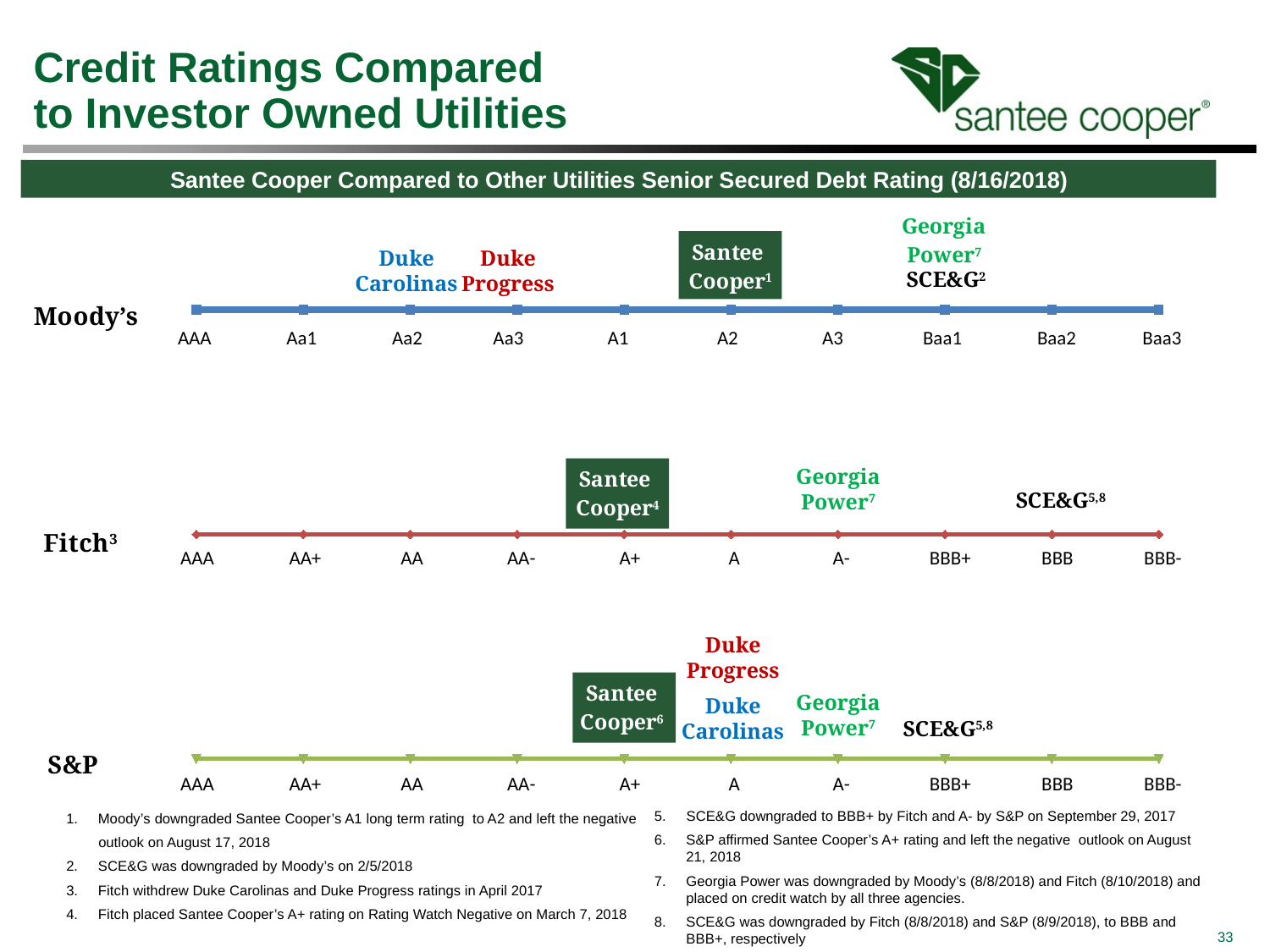
On the Moody's scale, which utility has the highest (best) rating? Duke Carolinas On the Moody's scale, at which rating is Duke Carolinas positioned? Aa2 How many rating agency scales are shown on the slide? 3 On the Fitch scale, at which rating is Georgia Power positioned? A- On the Moody's scale, at which rating is Duke Progress positioned? Aa3 On the Fitch scale, at which rating is Santee Cooper positioned? A+ How many rating ticks are shown on the Moody's scale? 10 On the S&P scale, at which rating are Duke Progress and Duke Carolinas positioned? A What is the title of the chart on the slide? Santee Cooper Compared to Other Utilities Senior Secured Debt Rating (8/16/2018) On the Moody's scale, at which rating are Georgia Power and SCE&G positioned? Baa1 On the S&P scale, at which rating is SCE&G positioned? BBB+ On the Moody's scale, at which rating is Santee Cooper positioned? A2